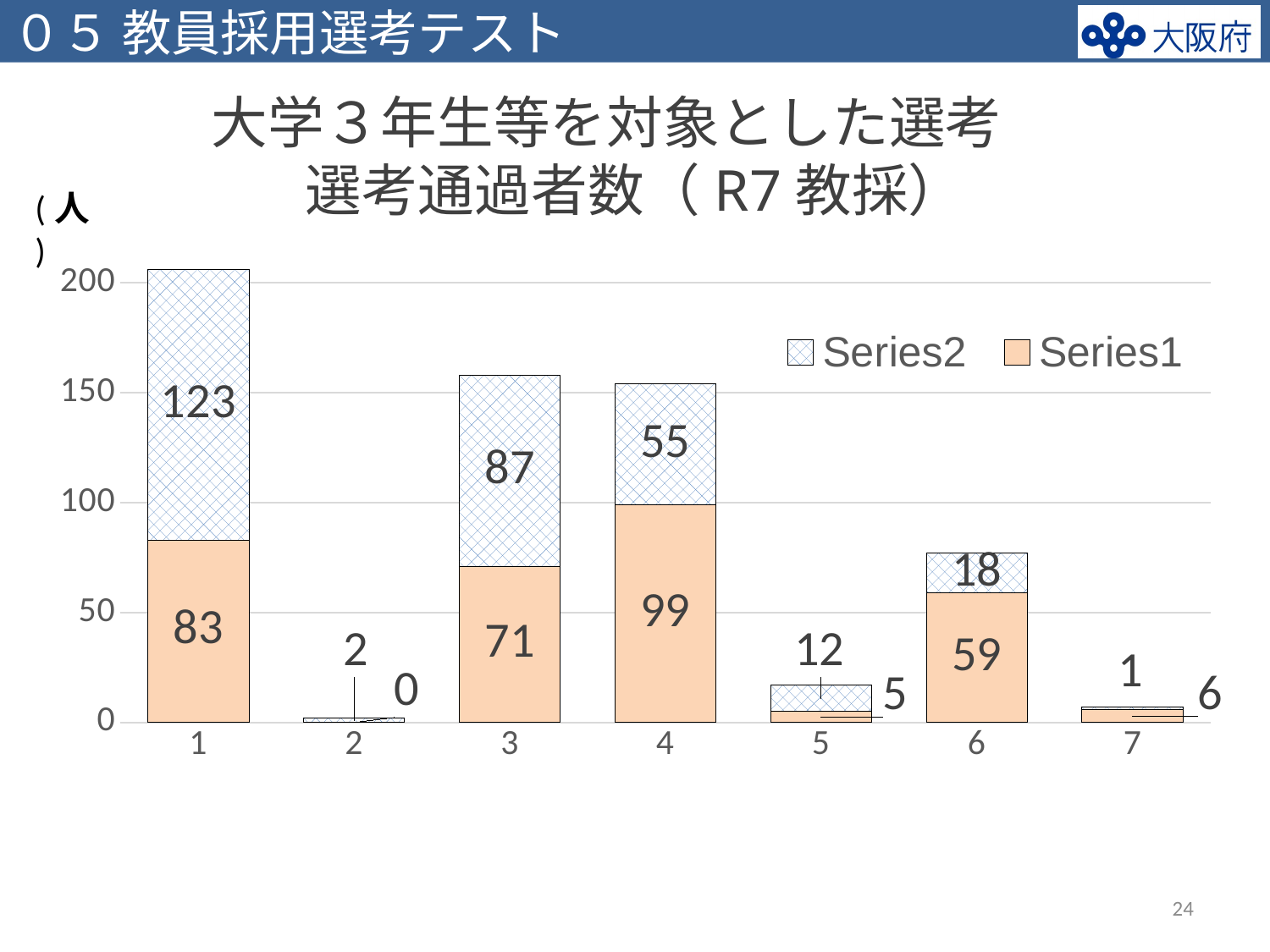
What is the difference between the Series2 and Series1 values for category 1? 40 Which category has the highest Series2 value? 1 What is the Series2 value for category 6? 18 What is the total of the stacked bar for category 6? 77 What is the total of the stacked bar for category 3? 158 Which is larger for category 4, the Series1 value or the Series2 value? Series1 What is the Series2 value for category 1? 123 Which category has the highest Series1 value? 4 What is the Series1 value for category 4? 99 What is the Series1 value for category 1? 83 How many categories are shown on the x axis? 7 What kind of chart is shown on the slide? Stacked bar chart